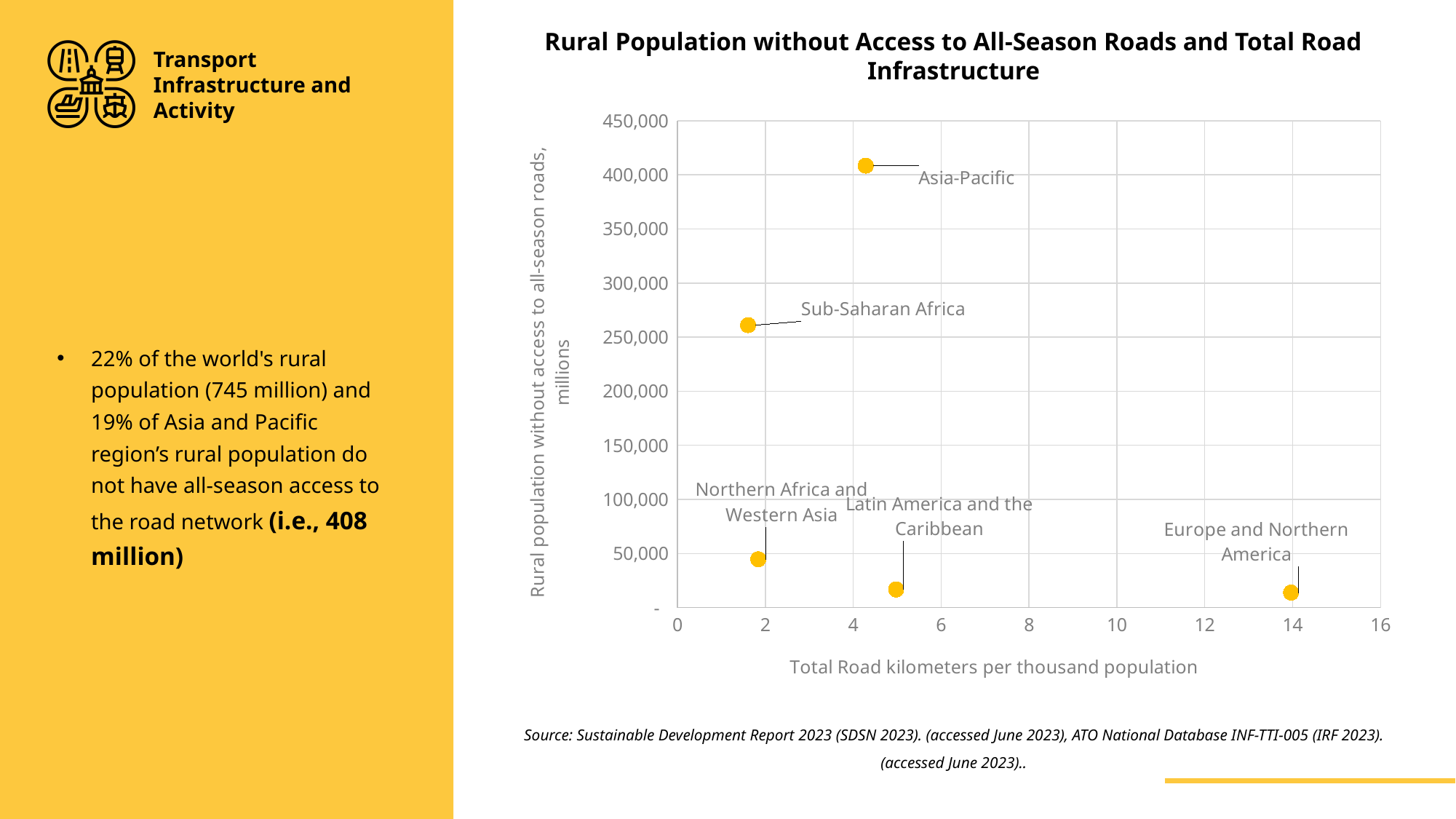
Which has more total road kilometers per thousand population, Europe and Northern America or Latin America and the Caribbean? Europe and Northern America Is the rural population without access to all-season roads for Northern Africa and Western Asia greater or less than 100,000? less Which region has the highest total road kilometers per thousand population? Europe and Northern America How many regions are plotted in the chart? 5 Is the total road kilometers per thousand population for Europe and Northern America greater or less than 12? greater Is the rural population without access to all-season roads for Sub-Saharan Africa greater or less than 250,000? greater What is the title of the chart? Rural Population without Access to All-Season Roads and Total Road Infrastructure What is the label of the x axis of the chart? Total Road kilometers per thousand population Which region has the highest rural population without access to all-season roads? Asia-Pacific Which has a larger rural population without access to all-season roads, Asia-Pacific or Sub-Saharan Africa? Asia-Pacific What kind of chart is shown on the slide? Scatter chart